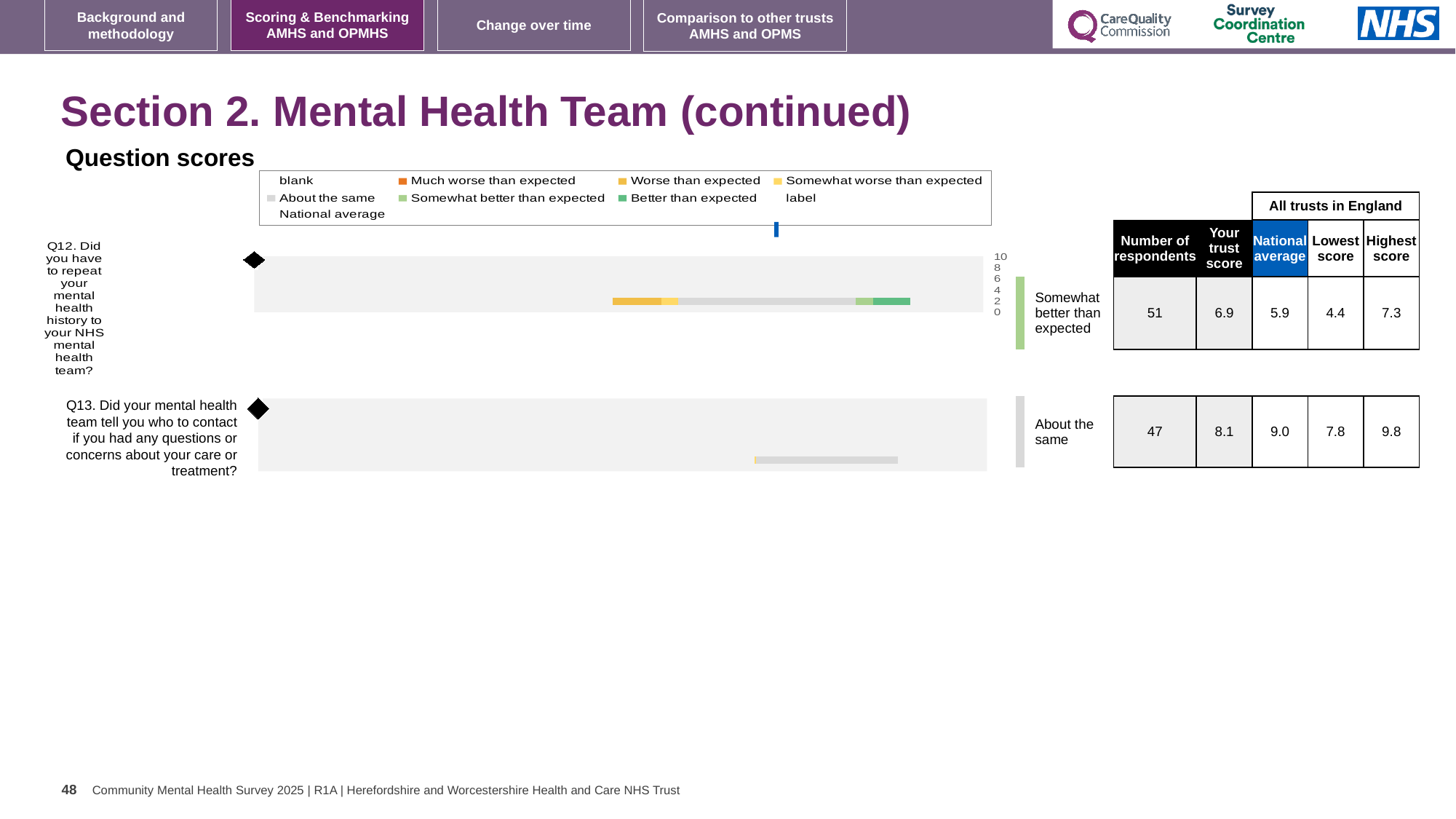
What kind of chart is used to show the question scores for Q12 and Q13? bar chart What is the highest score across all trusts in England for Q13? 9.8 What is the trust score for Q12 (repeating mental health history)? 6.9 How many respondents answered Q12? 51 What is the difference between the highest and lowest scores for Q12? 2.9 What is the national average for Q13 (told who to contact with questions or concerns)? 9.0 What rating category is shown for Q13? About the same For Q12, is the trust score higher or lower than the national average? higher How many questions are plotted on the slide? 2 What is the lowest score across all trusts in England for Q12? 4.4 What is the difference between the national average and the trust score for Q13? 0.9 Which question has the higher trust score, Q12 or Q13? Q13